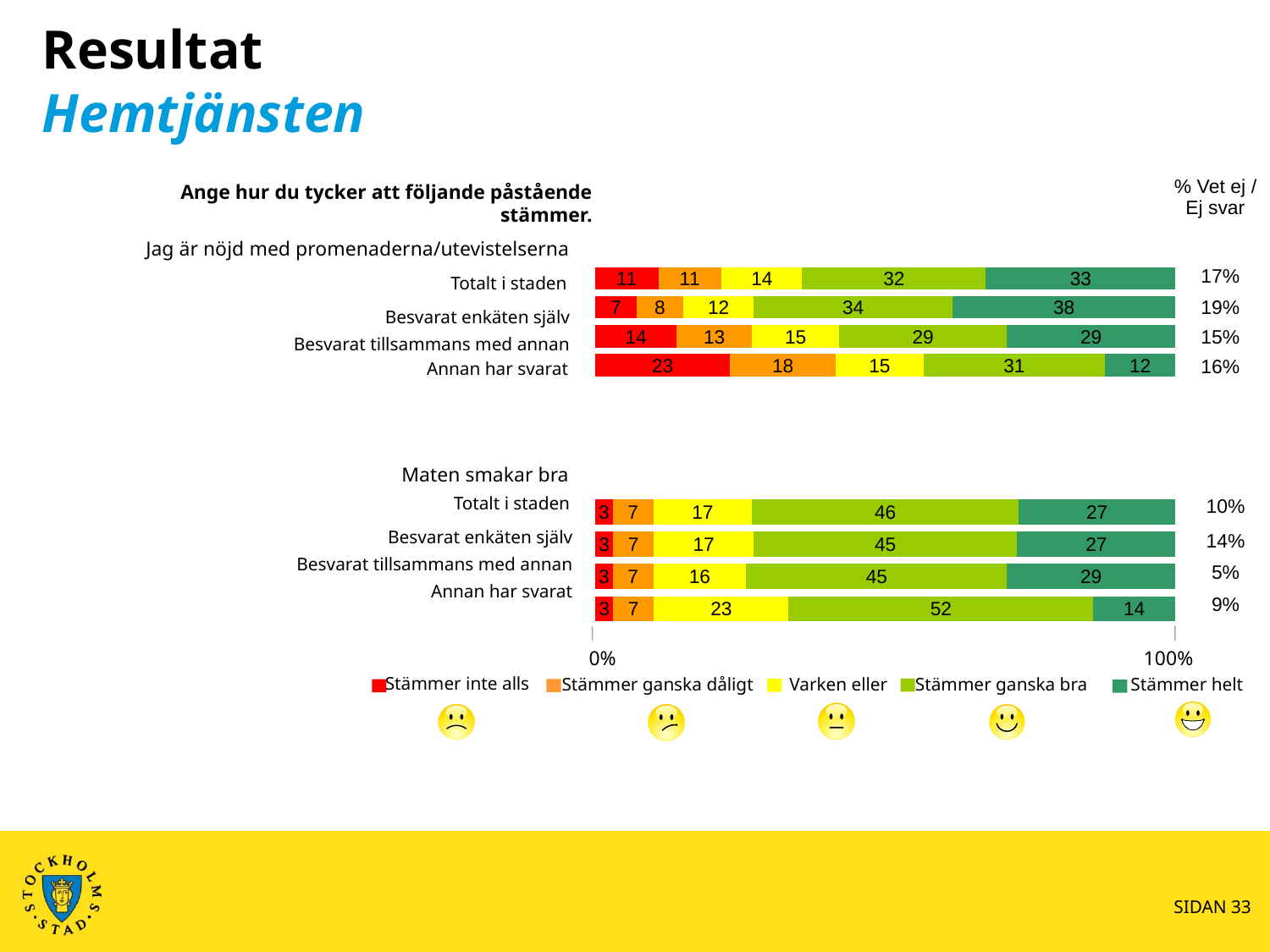
How many categories (rows) are shown in the 'Maten smakar bra' chart? 4 In the 'Jag är nöjd med promenaderna/utevistelserna' chart, what is the 'Stämmer helt' value for 'Besvarat enkäten själv'? 38 How many series does the legend list? 5 In the 'Maten smakar bra' chart, which category has the lowest 'Stämmer helt' value? Annan har svarat In the 'Jag är nöjd med promenaderna/utevistelserna' chart, what is the difference between the 'Stämmer helt' values for 'Besvarat enkäten själv' and 'Annan har svarat'? 26 Which legend entry is shown in red? Stämmer inte alls In the 'Maten smakar bra' chart, what is the 'Stämmer ganska bra' value for 'Annan har svarat'? 52 In the 'Jag är nöjd med promenaderna/utevistelserna' chart, what is the 'Stämmer ganska dåligt' value for 'Besvarat tillsammans med annan'? 13 In the 'Jag är nöjd med promenaderna/utevistelserna' chart, which category has the highest 'Stämmer inte alls' value? Annan har svarat In the 'Maten smakar bra' chart, is the 'Varken eller' value larger for 'Annan har svarat' or for 'Totalt i staden'? Annan har svarat What is the '% Vet ej / Ej svar' value shown for 'Besvarat tillsammans med annan' in the 'Maten smakar bra' chart? 5% What kind of chart is used on this slide? Stacked bar chart